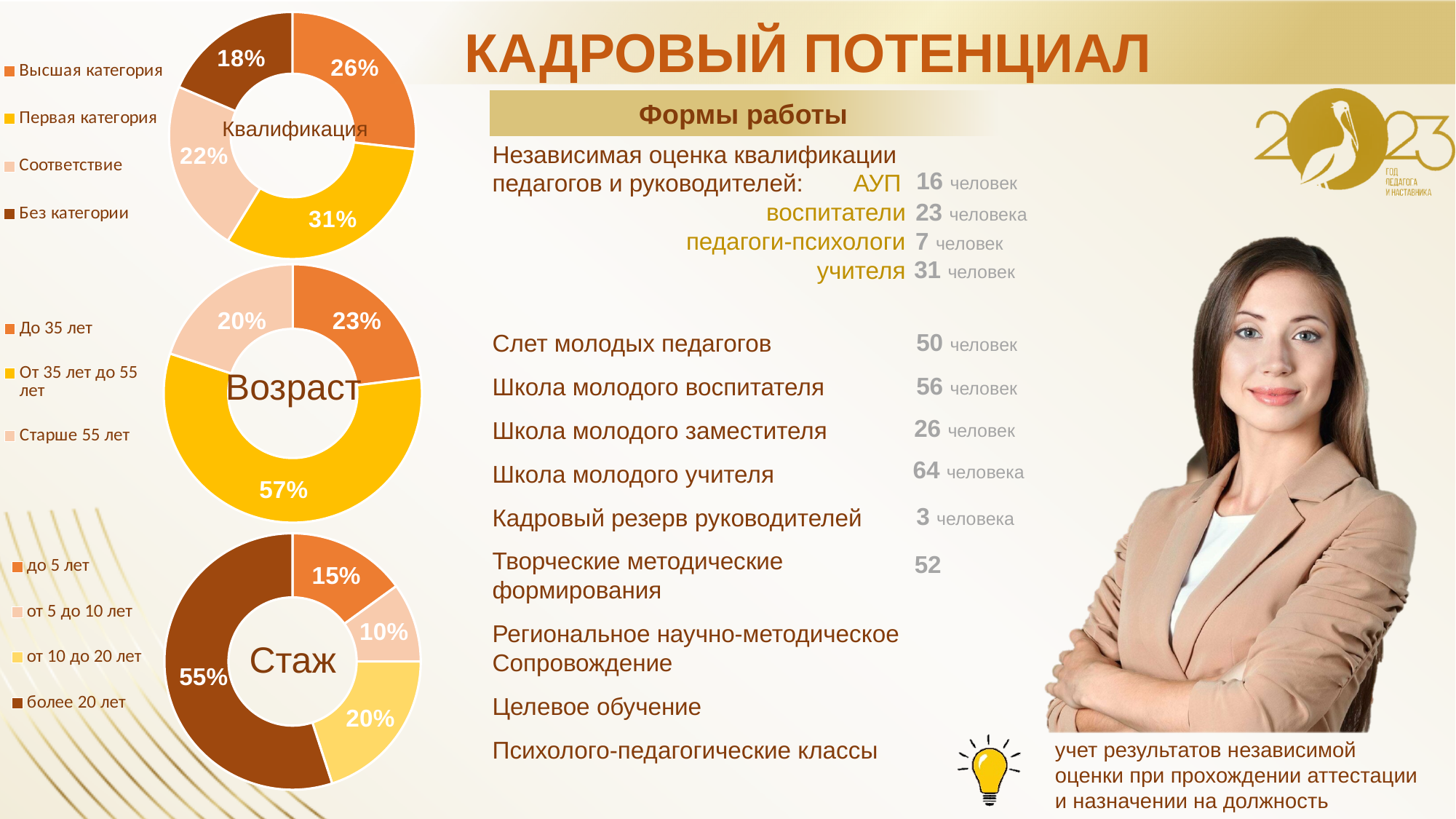
In the "Квалификация" chart, which category has the smallest share? Без категории In the "Возраст" chart, which is larger: the share for "До 35 лет" or the share for "Старше 55 лет"? До 35 лет What type of chart is the "Стаж" chart? Doughnut chart In the "Стаж" chart, which category has the largest share? более 20 лет In the "Стаж" chart, what is the difference between the shares for "более 20 лет" and "до 5 лет"? 40% In the "Возраст" chart, what share is shown for "От 35 лет до 55 лет"? 57% How many categories does the "Возраст" chart show? 3 How many categories does the "Квалификация" chart show? 4 In the "Квалификация" chart, what is the difference between the shares for "Высшая категория" and "Соответствие"? 4% In the "Квалификация" chart, what share is shown for "Первая категория"? 31% In the "Стаж" chart, what share is shown for "от 5 до 10 лет"? 10% In the "Квалификация" chart, which colour represents "Без категории"? Brown